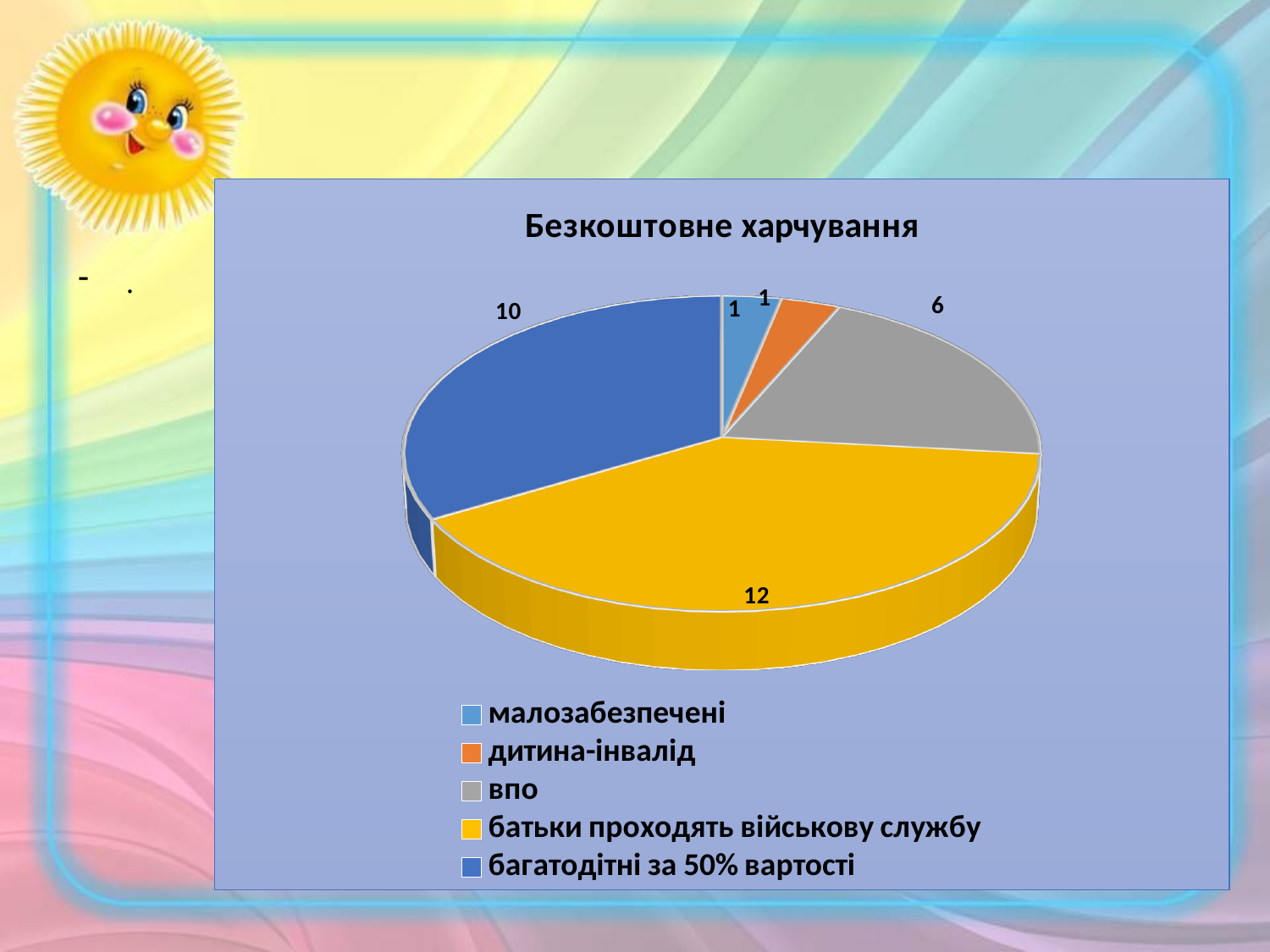
What is the value for "батьки проходять військову службу"? 12 What is the value for "впо"? 6 What kind of chart is shown on the slide? pie chart Which is larger, the value for "впо" or the value for "багатодітні за 50% вартості"? багатодітні за 50% вартості Which category has the largest slice? батьки проходять військову службу What is the total of all the slices in the pie? 30 What colour is the slice for "впо"? grey What is the difference between the values for "батьки проходять військову службу" and "багатодітні за 50% вартості"? 2 What is the value for "багатодітні за 50% вартості"? 10 How many categories does the legend list? 5 What is the value for "малозабезпечені"? 1 What is the title of the chart? Безкоштовне харчування